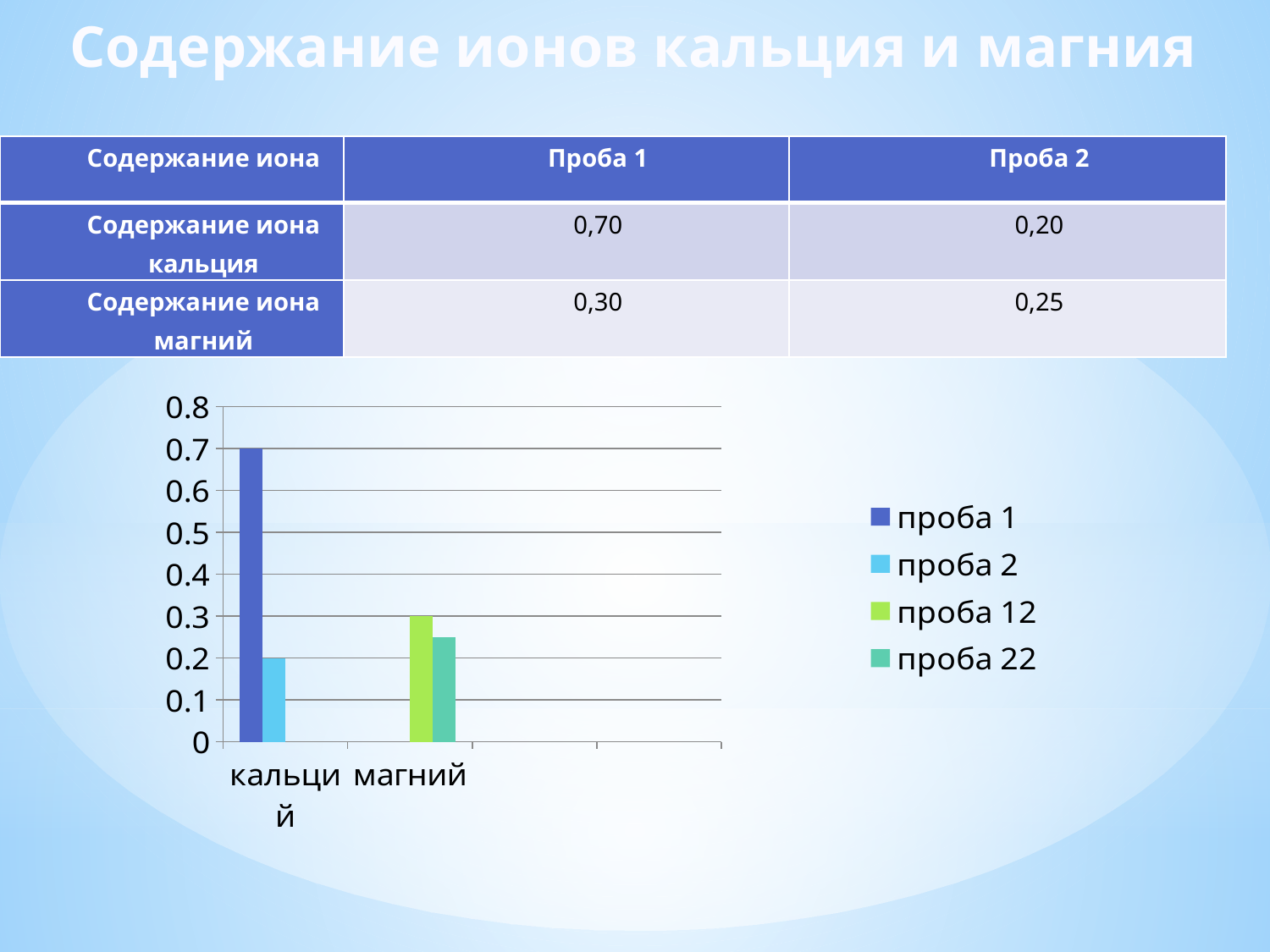
What is the highest value shown on the chart's vertical axis? 0.8 What is the value of проба 1 for кальций in the chart? 0.7 How many series does the chart legend list? 4 What kind of chart is shown on the slide? bar chart Is the value of проба 22 for магний greater or less than 0.3? less What are the legend entries of the chart? проба 1, проба 2, проба 12, проба 22 Which bar is the tallest in the chart? проба 1 for кальций What is the value of проба 12 for магний in the chart? 0.3 How many categories are shown on the x axis of the chart? 2 What is the difference between проба 1 and проба 2 for кальций? 0.5 What is the value of проба 2 for кальций in the chart? 0.2 Which is larger: проба 2 for кальций or проба 12 for магний? проба 12 for магний